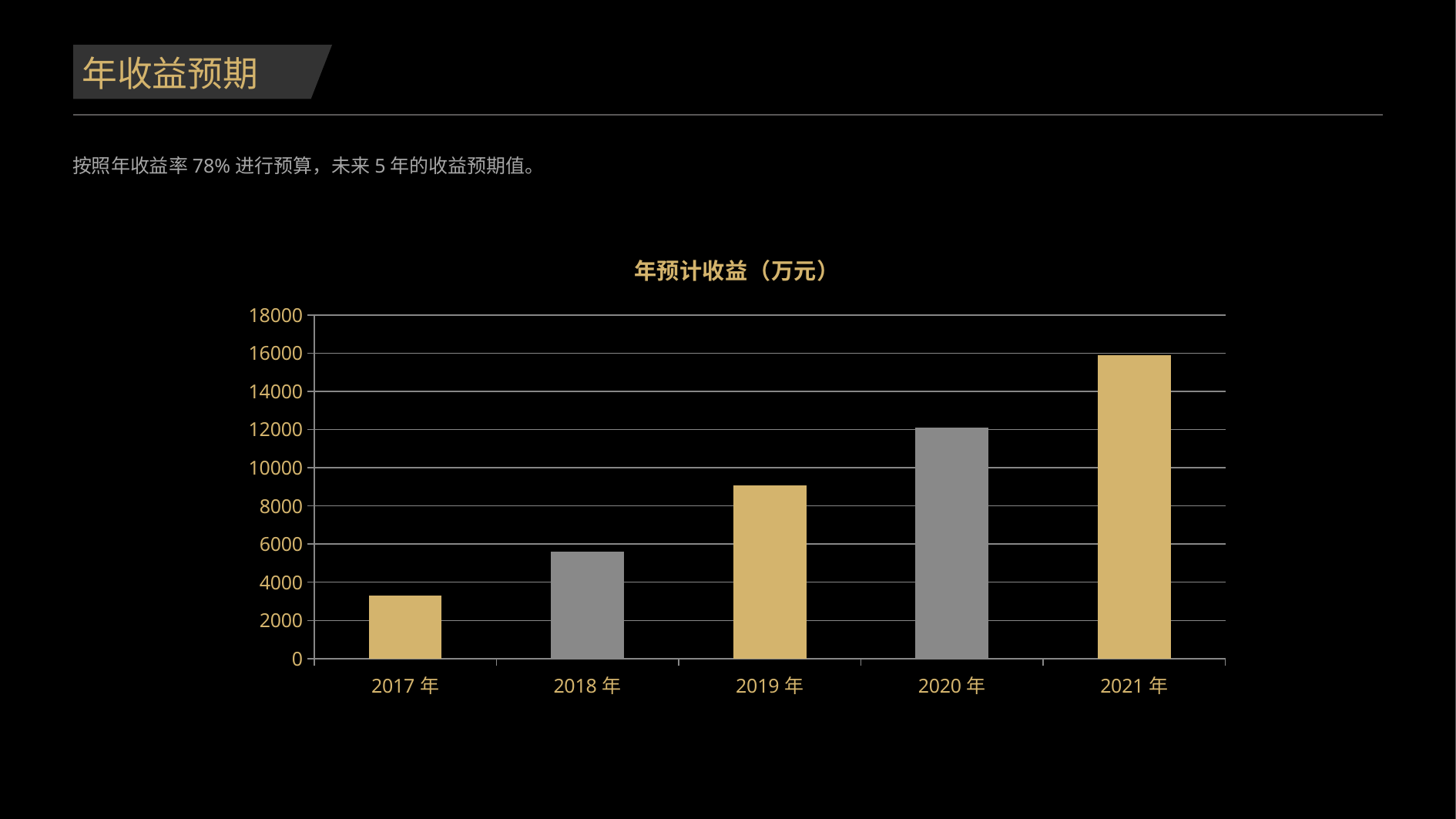
Is the value for 2017 年 greater or less than 4000? less Which is larger, the value for 2019 年 or the value for 2020 年? 2020 年 Is the value for 2019 年 greater or less than 8000? greater Is the value for 2021 年 greater or less than 14000? greater Do the values rise or fall from 2017 年 to 2021 年? rise How many years are plotted on the chart? 5 What is the title of the chart? 年预计收益（万元） Which year has the lowest projected annual income? 2017 年 What kind of chart is shown on the slide? bar chart Which year has the highest projected annual income? 2021 年